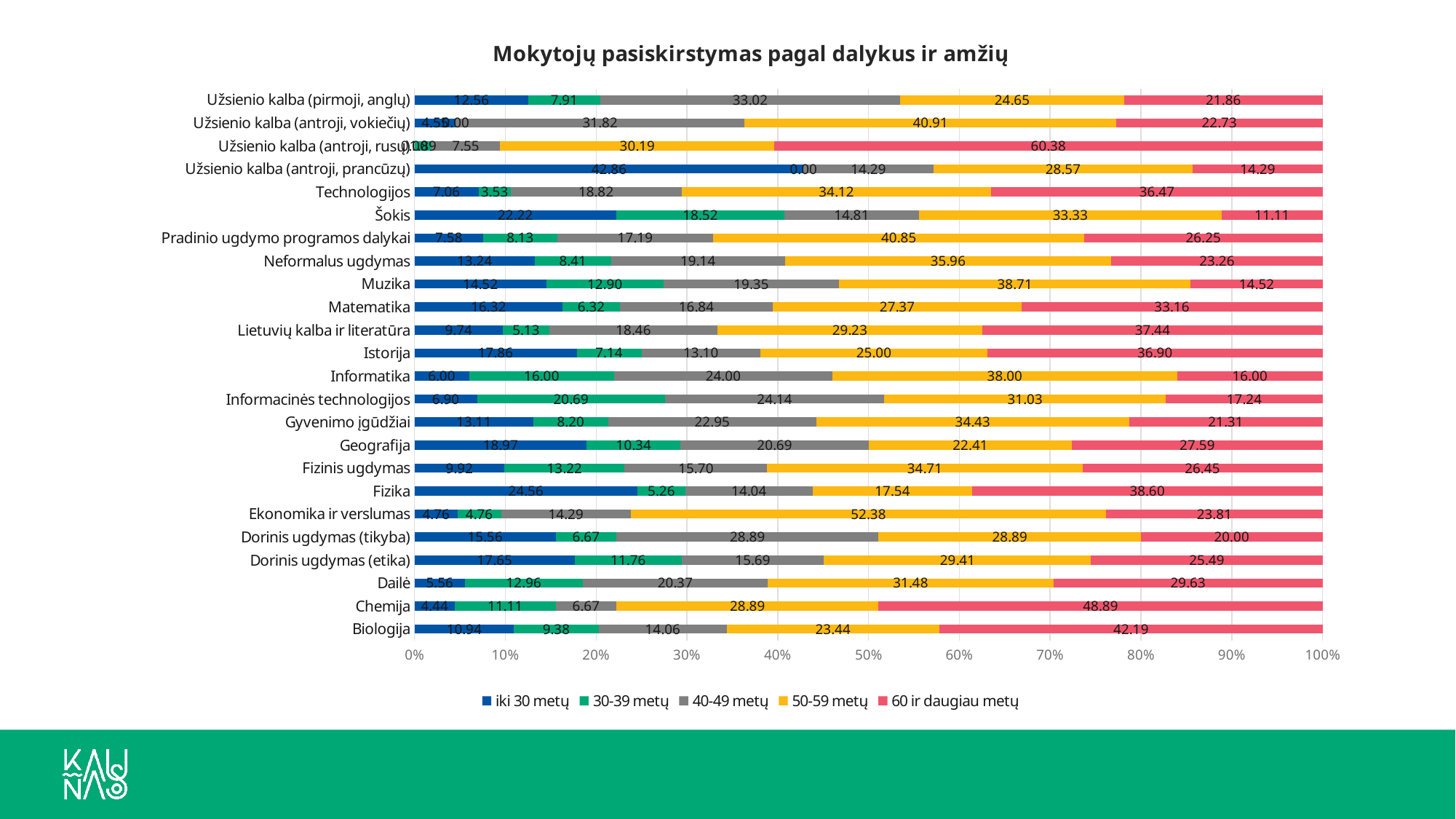
What is the title of the chart? Mokytojų pasiskirstymas pagal dalykus ir amžių Which has the larger '60 ir daugiau metų' value, Istorija or Geografija? Istorija What is the value of the 'iki 30 metų' segment for Fizika? 24.56 What is the value of the '60 ir daugiau metų' segment for Chemija? 48.89 Which subject has the largest '60 ir daugiau metų' segment? Užsienio kalba (antroji, rusų) Which subject has the largest 'iki 30 metų' segment? Užsienio kalba (antroji, prancūzų) What kind of chart is shown on the slide? Stacked bar chart For Biologija, what is the difference between the '60 ir daugiau metų' value and the '50-59 metų' value? 18.75 How many subject categories are plotted on the chart? 24 How many series does the legend list? 5 What is the value of the '60 ir daugiau metų' segment for Matematika? 33.16 What is the value of the '50-59 metų' segment for Ekonomika ir verslumas? 52.38